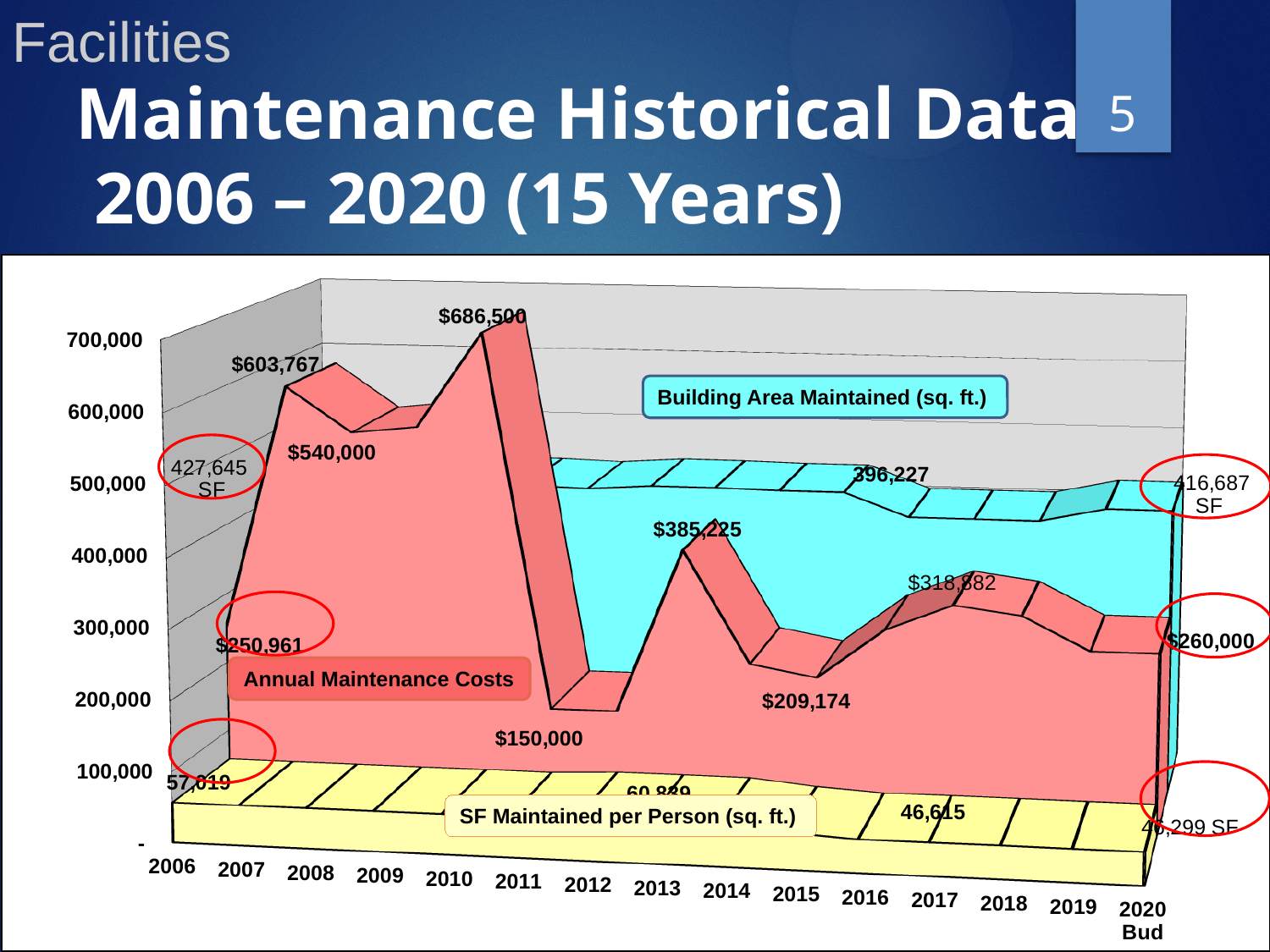
Does the SF Maintained per Person series rise or fall from 2006 to 2020 Bud? fall What is the Building Area Maintained value labelled at 2020 Bud? 416,687 SF What is the SF Maintained per Person value labelled at 2006? 57,019 How many data series are plotted in the chart? 3 Which is larger, the labelled maintenance cost of $603,767 or $540,000? $603,767 What is the Annual Maintenance Cost for 2020 Bud? $260,000 What is the difference between the highest labelled maintenance cost ($686,500) and the lowest labelled maintenance cost ($150,000)? $536,500 What is the highest labelled Annual Maintenance Cost value in the chart? $686,500 How many years (categories) are shown along the x axis? 15 What type of chart is shown on the slide? area chart What is the lowest labelled Annual Maintenance Cost value in the chart? $150,000 What is the Building Area Maintained value labelled at 2006? 427,645 SF